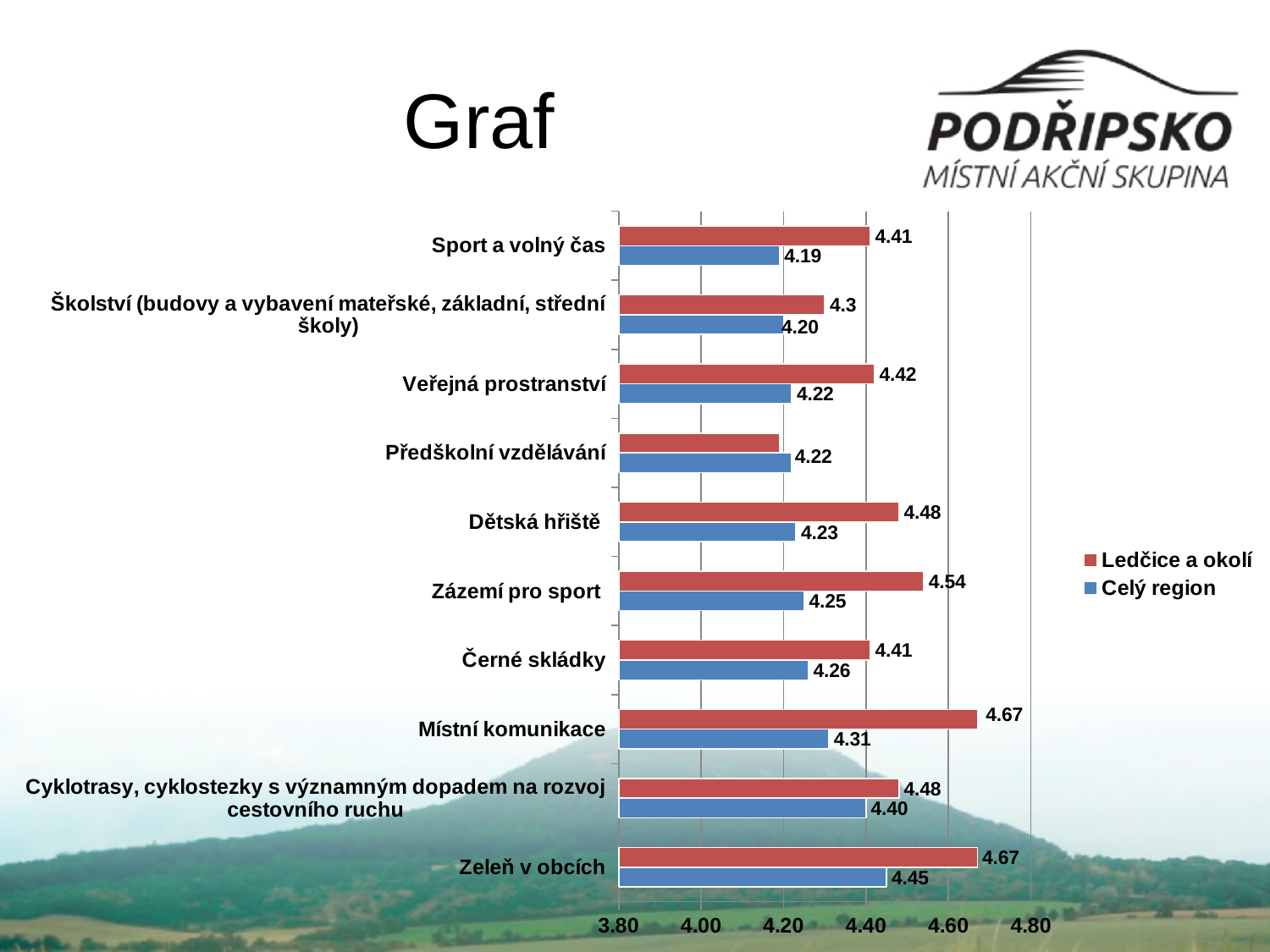
What is the difference between the Ledčice a okolí and Celý region values for Místní komunikace? 0.36 What is the value for Celý region in the category Zeleň v obcích? 4.45 What is the value for Celý region in the category Dětská hřiště? 4.23 What is the value for Ledčice a okolí in the category Zázemí pro sport? 4.54 What is the value for Ledčice a okolí in the category Místní komunikace? 4.67 Which category has the lowest value for Ledčice a okolí? Předškolní vzdělávání Which is larger for Cyklotrasy, cyklostezky s významným dopadem na rozvoj cestovního ruchu: the value for Ledčice a okolí or for Celý region? Ledčice a okolí How many categories are plotted in the chart? 10 How many series does the legend list? 2 Which category has the highest value for Celý region? Zeleň v obcích Is the value for Ledčice a okolí in the category Předškolní vzdělávání greater or less than 4.40? less What kind of chart is shown on the slide? bar chart